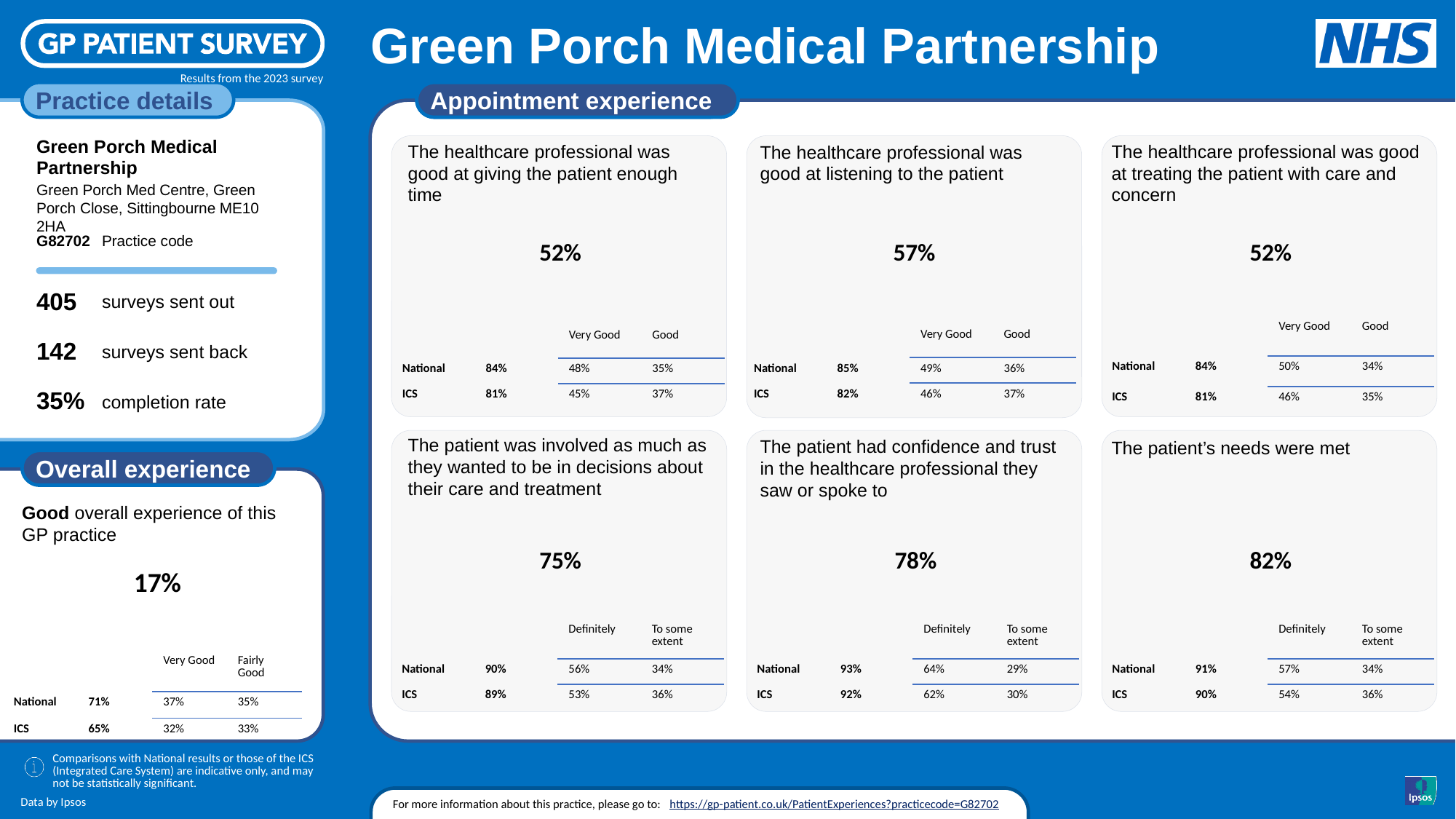
In the 'Appointment experience' section, which of the six measures has the highest practice value? The patient's needs were met In the 'Overall experience' panel, what is the National figure for good overall experience? 71% In the 'The patient was involved as much as they wanted to be in decisions about their care and treatment' panel, what is the difference between the National figure (90%) and the practice figure (75%)? 15 percentage points In the 'Overall experience' panel, what is the ICS 'Fairly Good' value? 33% In the 'Appointment experience' section, what is the practice value for 'The healthcare professional was good at listening to the patient'? 57% In the 'The patient had confidence and trust in the healthcare professional they saw or spoke to' panel, what is the National 'Definitely' value? 64% How many measures are shown in the 'Appointment experience' section? 6 In the 'The patient's needs were met' panel, which is larger: the National figure or the ICS figure? National In the 'Overall experience' panel, what is the difference between the National figure (71%) and the practice figure (17%)? 54 percentage points In the 'Appointment experience' section, which measures share the lowest practice value of 52%? The healthcare professional was good at giving the patient enough time; The healthcare professional was good at treating the patient with care and concern In the 'The healthcare professional was good at treating the patient with care and concern' panel, what is the ICS 'Very Good' value? 46% In the 'Overall experience' panel, what percentage of patients reported a good overall experience of this GP practice? 17%